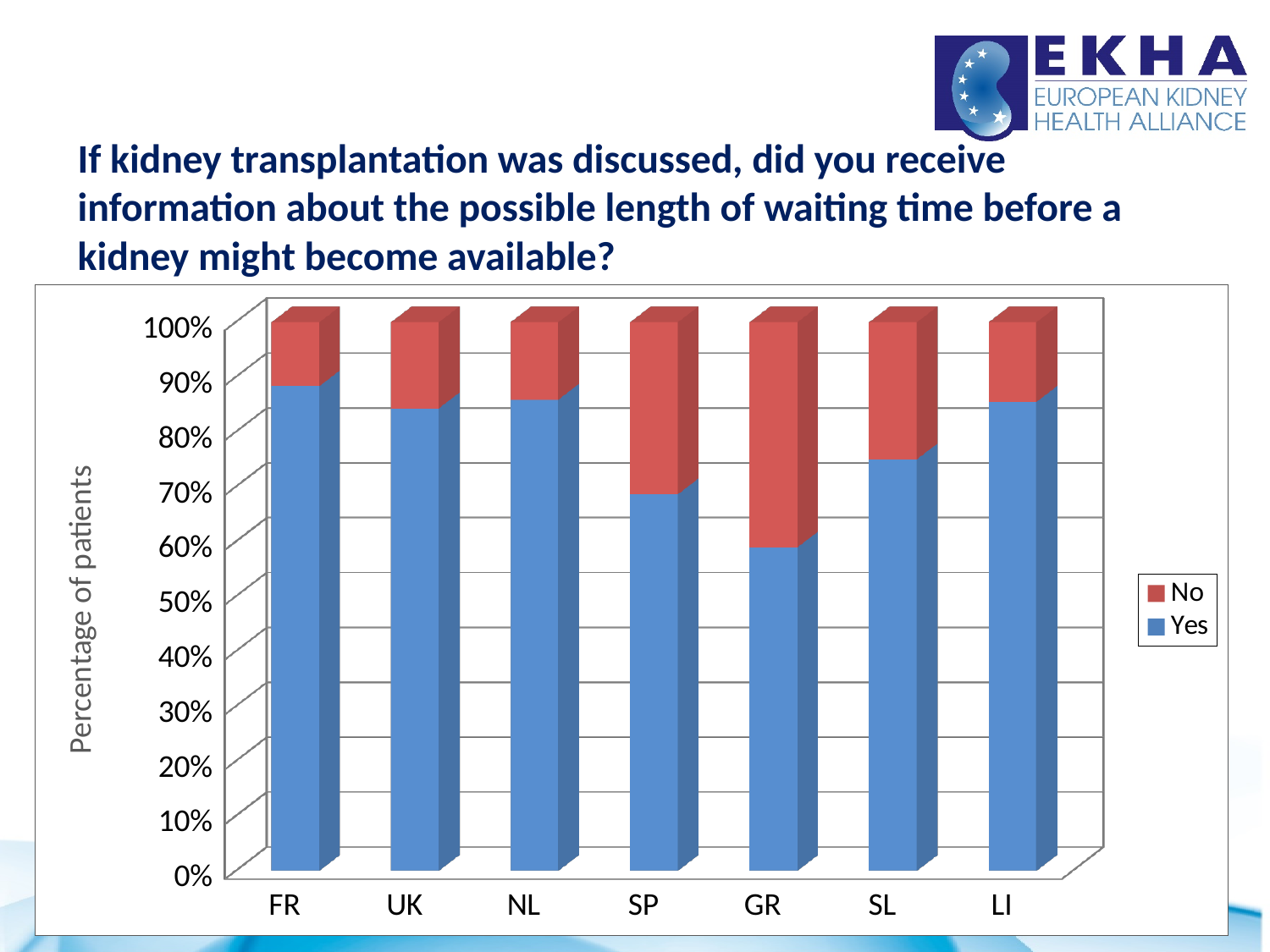
Is the Yes value for GR greater or less than 50%? greater Is the Yes value for SL greater or less than 70%? greater Is the Yes value for SP greater or less than 60%? greater Which country has the largest No segment? GR What kind of chart is shown on the slide? Stacked bar chart Which country has the lowest share of patients answering Yes? GR Which country has a larger Yes share, SP or GR? SP What is the label on the vertical axis of the chart? Percentage of patients What do the Yes and No segments for each country add up to? 100% How many countries are shown on the x axis of the chart? 7 How many series does the chart's legend list? 2